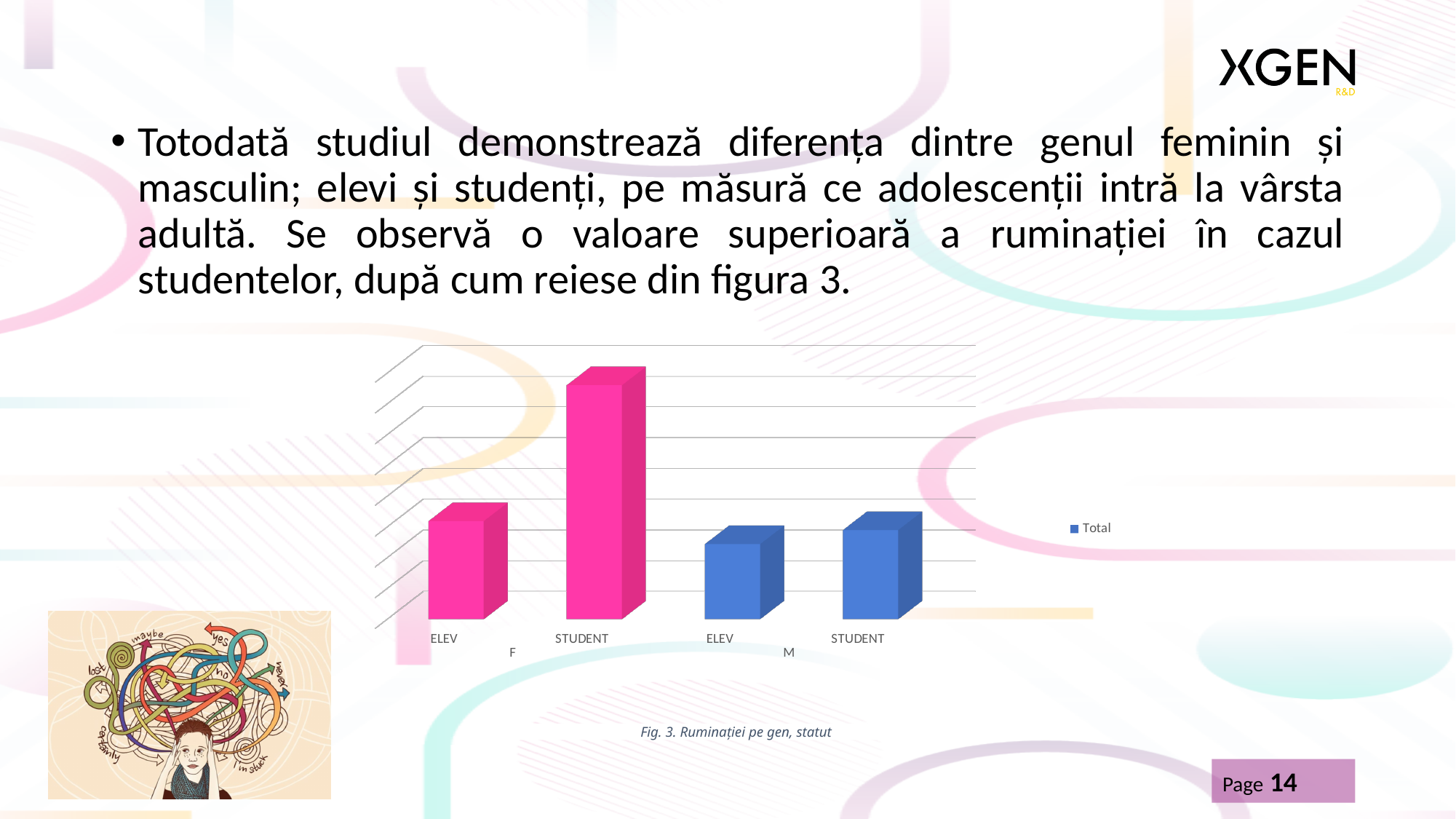
How many bars are plotted in the chart? 4 Which bar in the chart is the highest? STUDENT (F) Which is larger: STUDENT in the F group or STUDENT in the M group? STUDENT in the F group What is the caption of the figure below the chart? Fig. 3. Ruminației pe gen, statut Which bar in the chart is the lowest? ELEV (M) Which is larger: ELEV in the F group or ELEV in the M group? ELEV in the F group In the F group, which is larger: ELEV or STUDENT? STUDENT How many series does the chart legend list? 1 What kind of chart is shown on the slide? bar chart What is the name of the series shown in the chart legend? Total